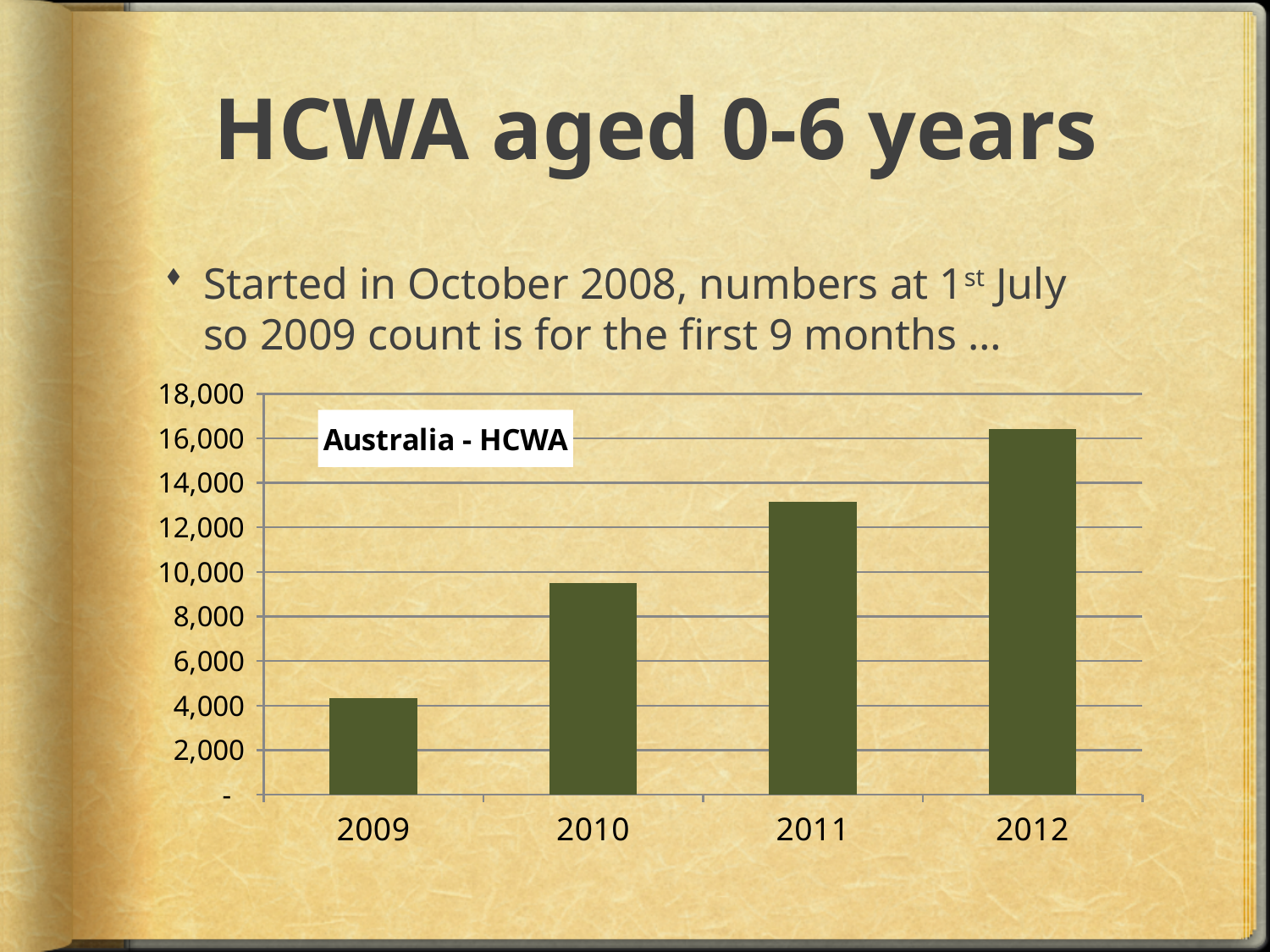
How many years are shown on the x axis of the chart? 4 Is the value for 2012 greater or less than 14,000? greater Which year has the highest bar in the chart? 2012 Is the value for 2011 greater or less than 12,000? greater Do the values rise or fall from 2009 to 2012? rise What kind of chart is shown on the slide? bar chart Is the value for 2010 greater or less than 10,000? less Which year has the larger value, 2010 or 2011? 2011 Which year has the lowest bar in the chart? 2009